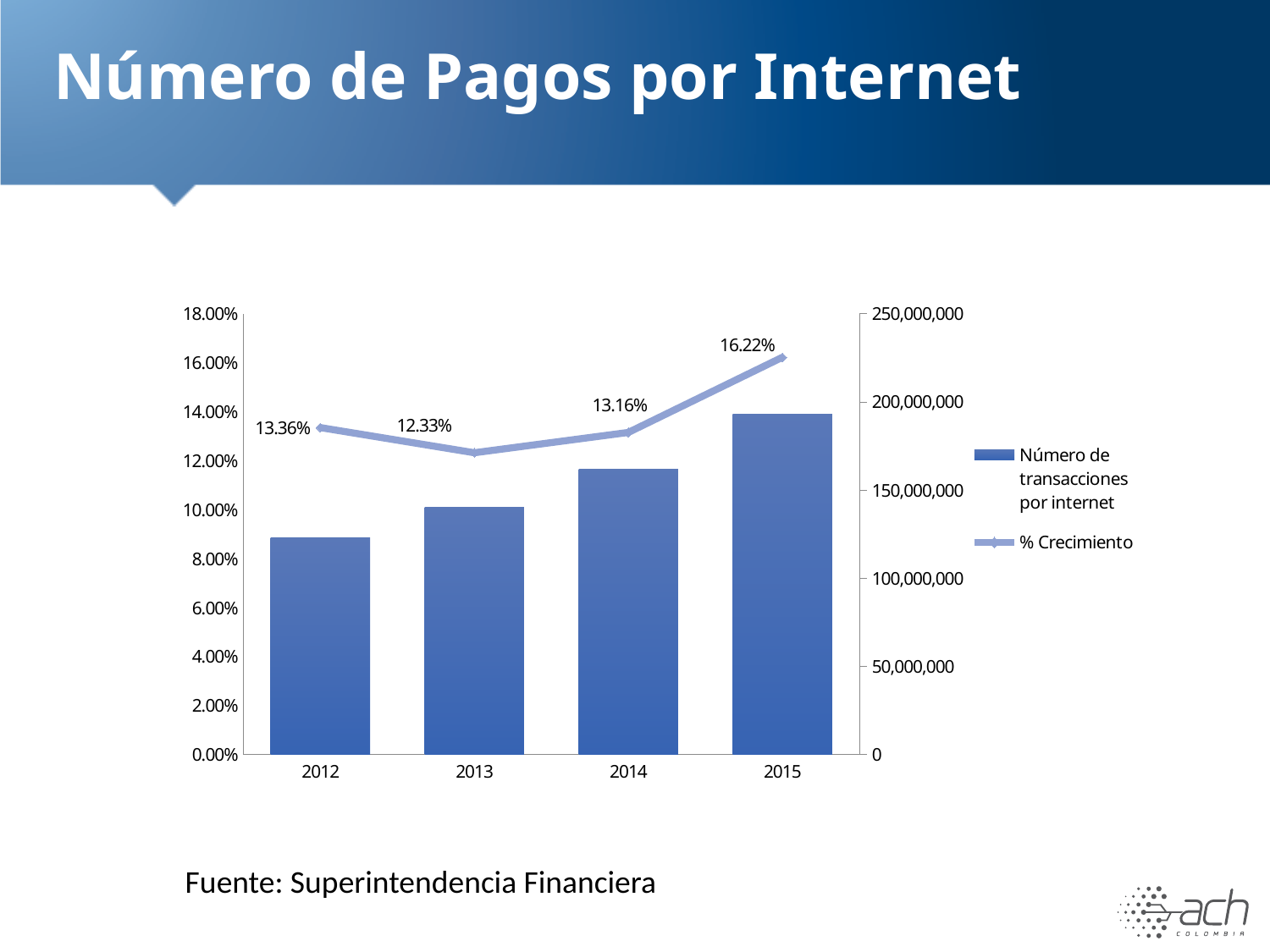
Which year has the highest % Crecimiento? 2015 What is the % Crecimiento value for 2013? 12.33% How many years are shown on the x axis? 4 Is the Número de transacciones por internet for 2015 greater or less than 150,000,000? greater What is the % Crecimiento value for 2012? 13.36% Do the Número de transacciones por internet bars rise or fall from 2012 to 2015? rise Which year has a higher % Crecimiento, 2012 or 2014? 2012 What is the difference between the % Crecimiento for 2015 and 2013? 3.89% Is the Número de transacciones por internet for 2012 greater or less than 150,000,000? less How many series does the legend list? 2 What is the % Crecimiento value for 2015? 16.22% Which year has the lowest % Crecimiento? 2013